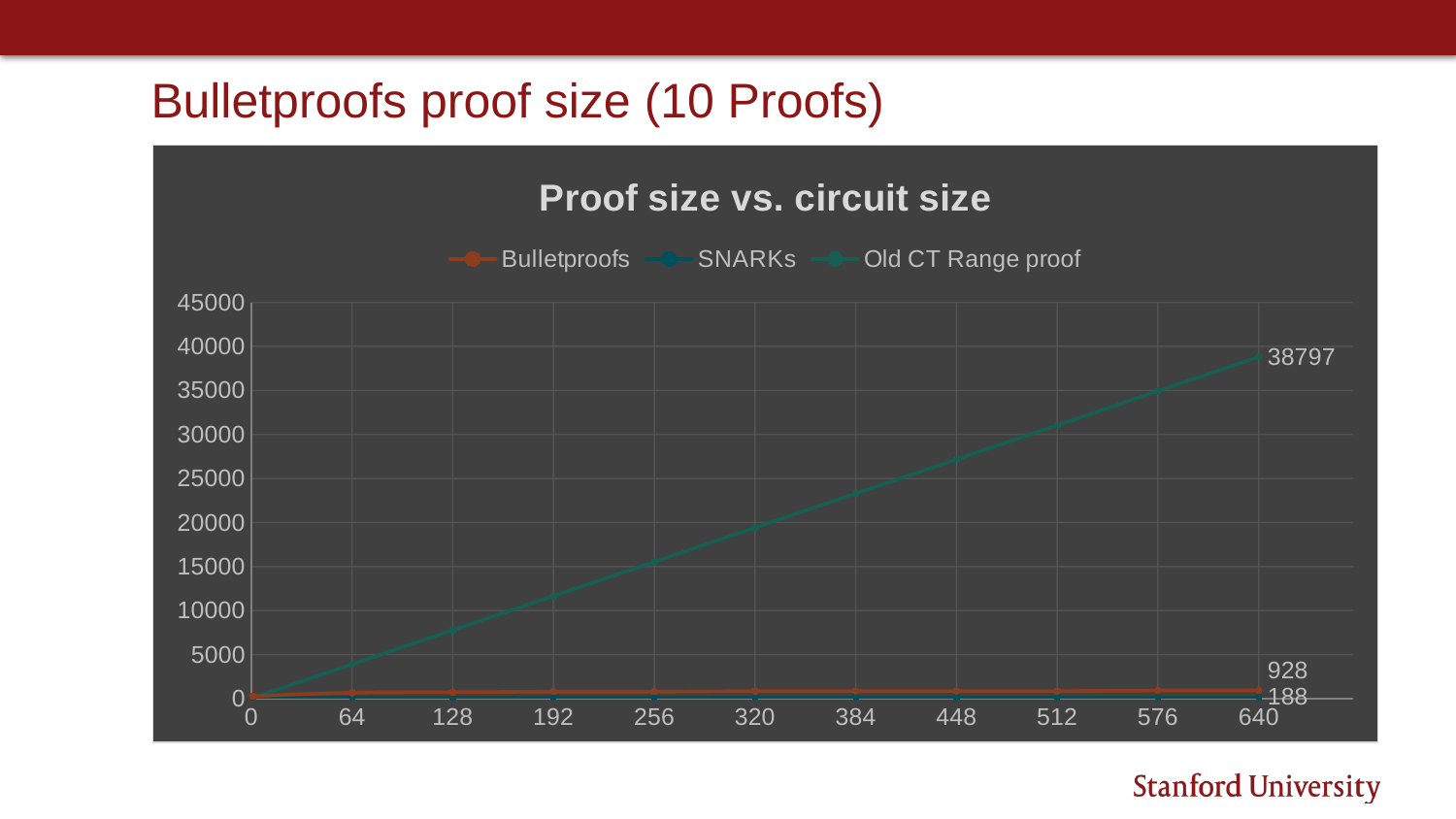
What is the value of the SNARKs series at circuit size 640? 188 At circuit size 640, which is larger: the Bulletproofs value or the SNARKs value? Bulletproofs What is the value of the Old CT Range proof series at circuit size 640? 38797 What is the title of the chart? Proof size vs. circuit size Does the Old CT Range proof series rise or fall as circuit size increases along the x axis? rise Which series has the lowest value at circuit size 640? SNARKs What is the value of the Bulletproofs series at circuit size 640? 928 What is the difference between the Old CT Range proof value and the Bulletproofs value at circuit size 640? 37869 Is the value of the Old CT Range proof series at circuit size 320 greater or less than 15000? greater How many series does the legend list? 3 Which series has the highest value at circuit size 640? Old CT Range proof What kind of chart is shown on the slide? line chart